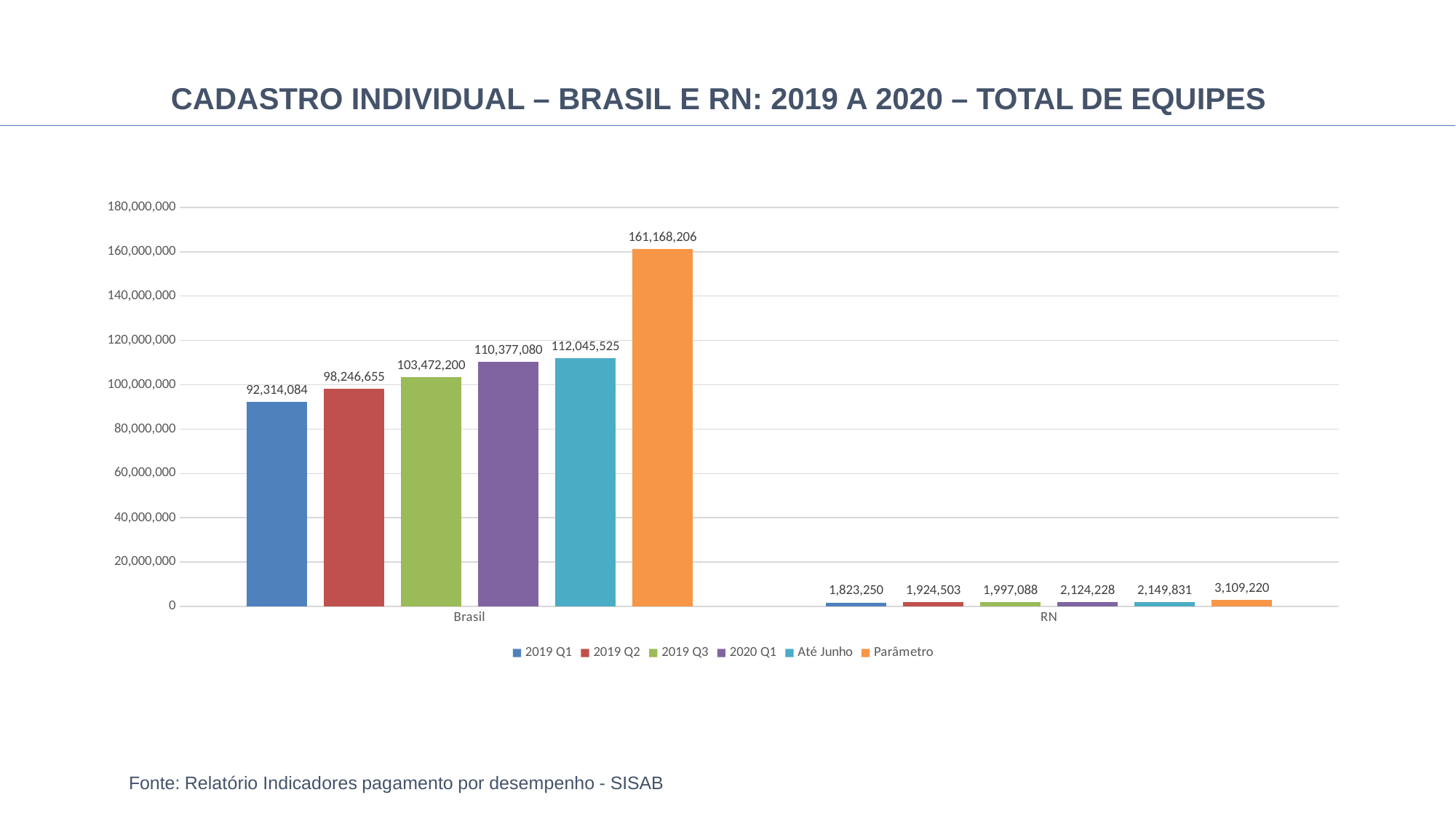
What is the difference between the 2019 Q2 and 2019 Q1 values for Brasil? 5,932,571 How many categories are shown on the x axis? 2 Which is larger for RN: the 2020 Q1 value or the 2019 Q3 value? 2020 Q1 What type of chart is shown on the slide? Bar chart How many series does the legend list? 6 Which series has the lowest value for RN? 2019 Q1 What is the difference between the Parâmetro value and the Até Junho value for Brasil? 49,122,681 What is the Até Junho value for Brasil? 112,045,525 Which series has the highest value for Brasil? Parâmetro What is the value for 2019 Q1 for Brasil? 92,314,084 What is the Parâmetro value for RN? 3,109,220 Is the Parâmetro value for Brasil greater or less than 160,000,000? greater